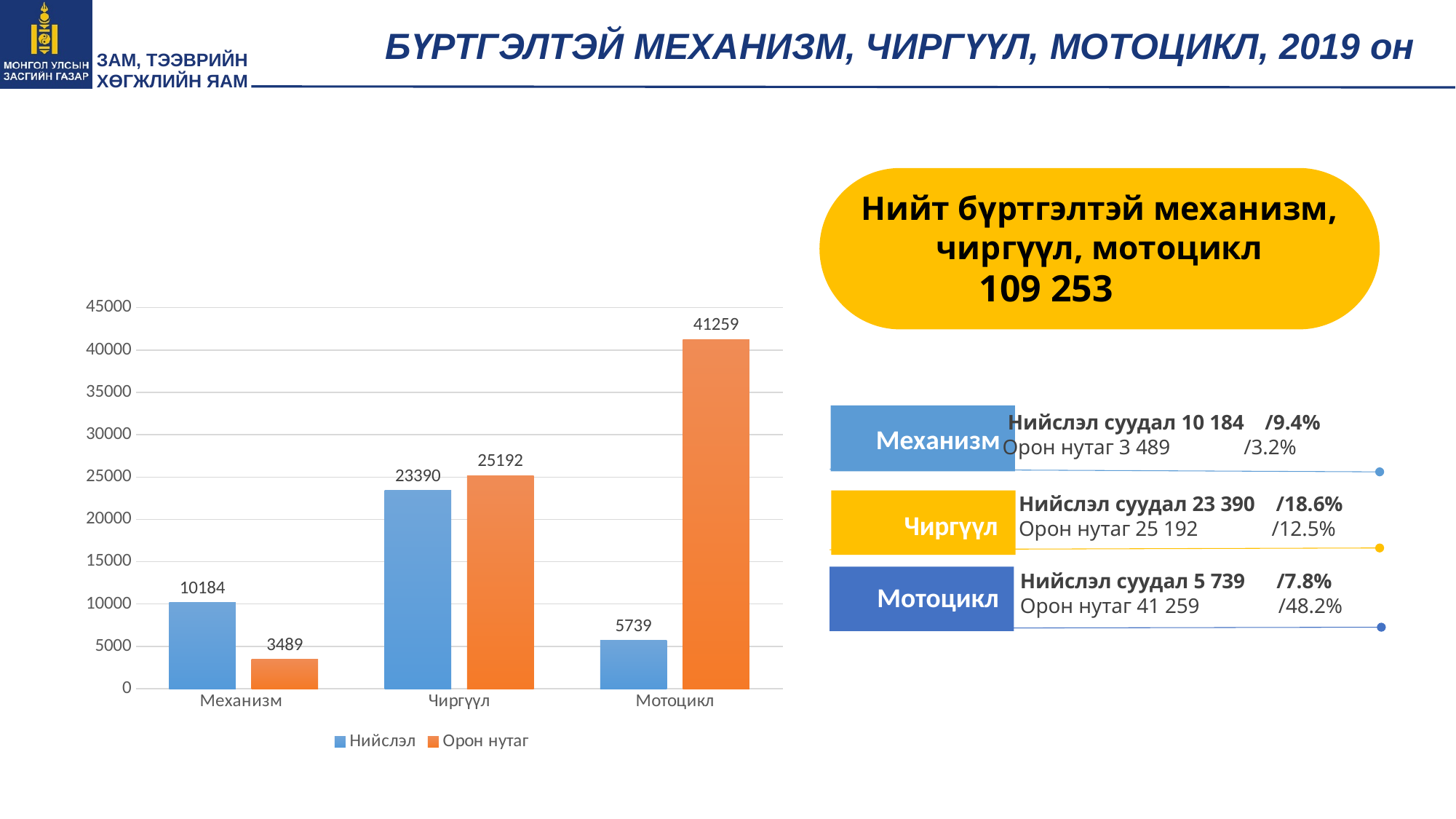
What is the value for Орон нутаг in the Чиргүүл category? 25192 What is the value for Орон нутаг in the Мотоцикл category? 41259 Is the Нийслэл value for Чиргүүл greater or less than 20000? greater Which category has the highest Орон нутаг value? Мотоцикл How many categories are shown on the x axis? 3 What colour are the Орон нутаг bars? orange Which is larger for Механизм: Нийслэл or Орон нутаг? Нийслэл Which category has the lowest Нийслэл value? Мотоцикл What kind of chart is shown on the slide? bar chart What is the difference between the Орон нутаг and Нийслэл values for Мотоцикл? 35520 How many series does the legend list? 2 What is the value for Нийслэл in the Механизм category? 10184